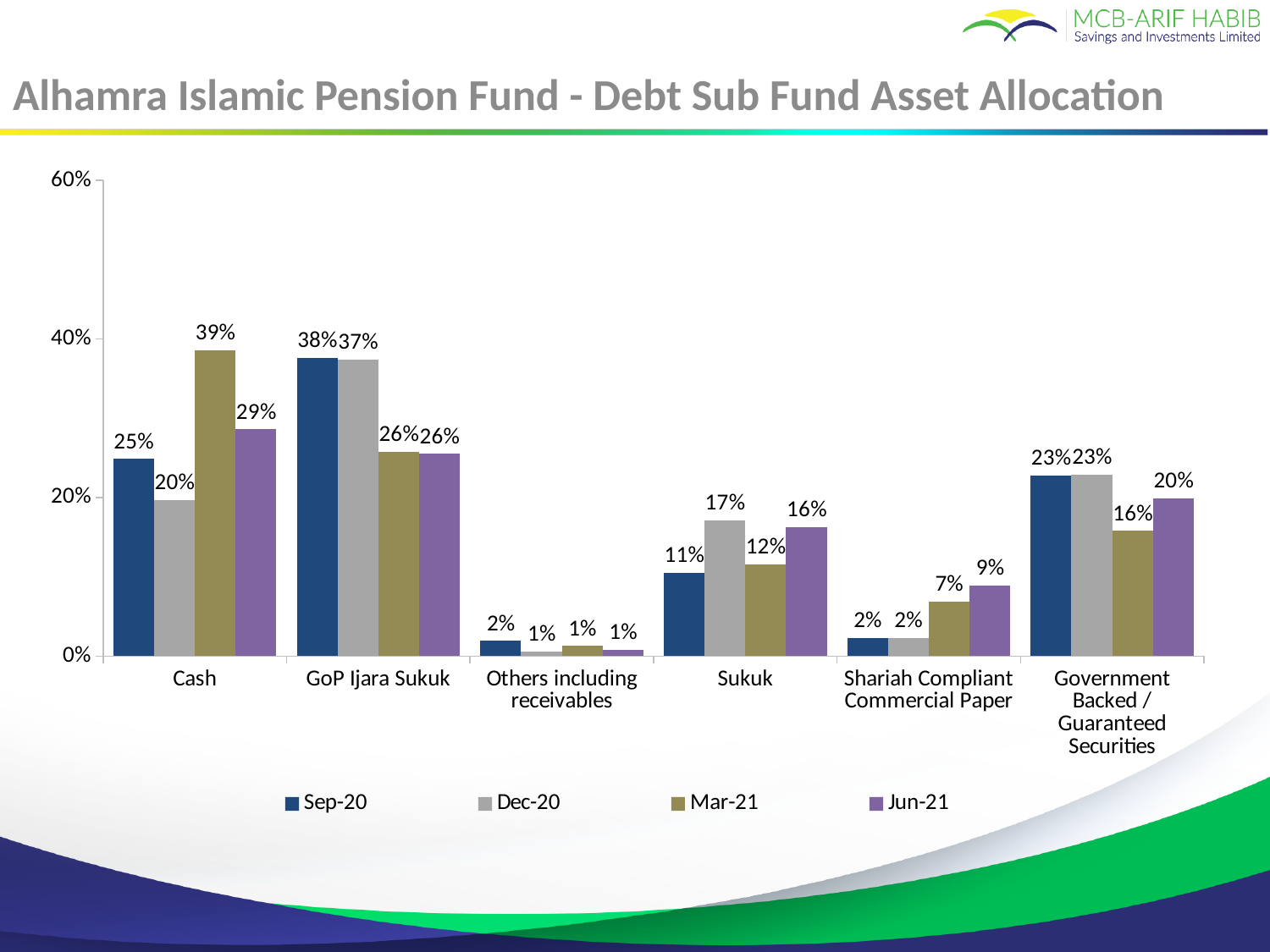
Which category has the highest Mar-21 value? Cash What kind of chart is shown on the slide? Bar chart What is the Dec-20 value for Sukuk? 17% What is the title of the slide? Alhamra Islamic Pension Fund - Debt Sub Fund Asset Allocation Which is larger for Government Backed / Guaranteed Securities: the Mar-21 value or the Jun-21 value? Jun-21 What is the Mar-21 value for Cash? 39% How many categories are shown on the x axis? 6 How many series does the legend list? 4 What is the Sep-20 value for GoP Ijara Sukuk? 38% What is the Jun-21 value for Shariah Compliant Commercial Paper? 9% What is the difference between the Mar-21 and Dec-20 values for Cash? 19%